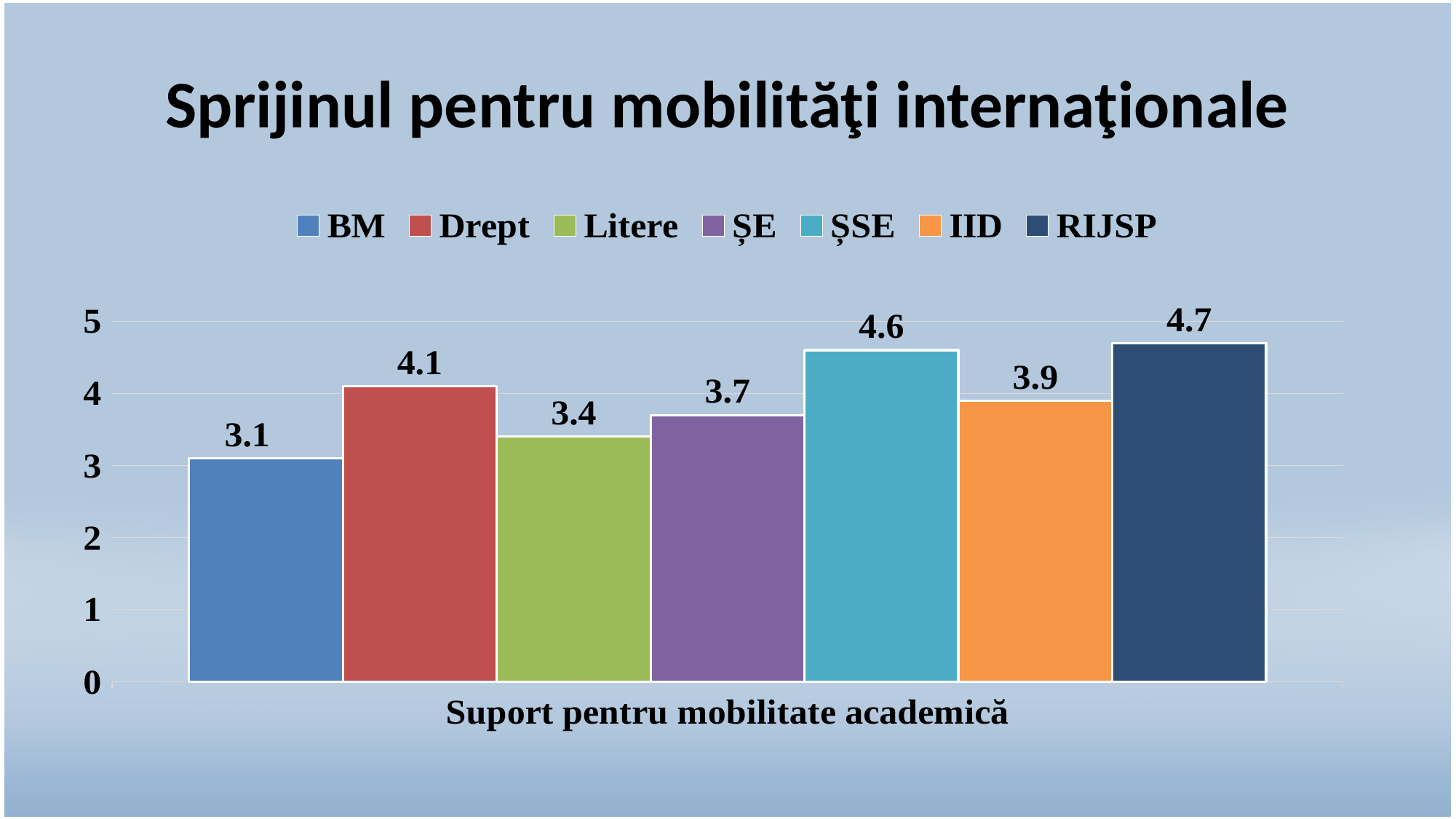
Which series has the lowest value? BM What is the title of the chart? Sprijinul pentru mobilităţi internaţionale What is the value for Litere? 3.4 What is the difference between the values for ȘSE and IID? 0.7 Which is larger, the value for ȘE or the value for Litere? ȘE Which series has the highest value? RIJSP What is the difference between the values for RIJSP and BM? 1.6 What is the value for ȘSE? 4.6 Is the value for IID greater or less than 4? less What is the value for Drept? 4.1 How many series does the legend list? 7 What kind of chart is shown on the slide? bar chart